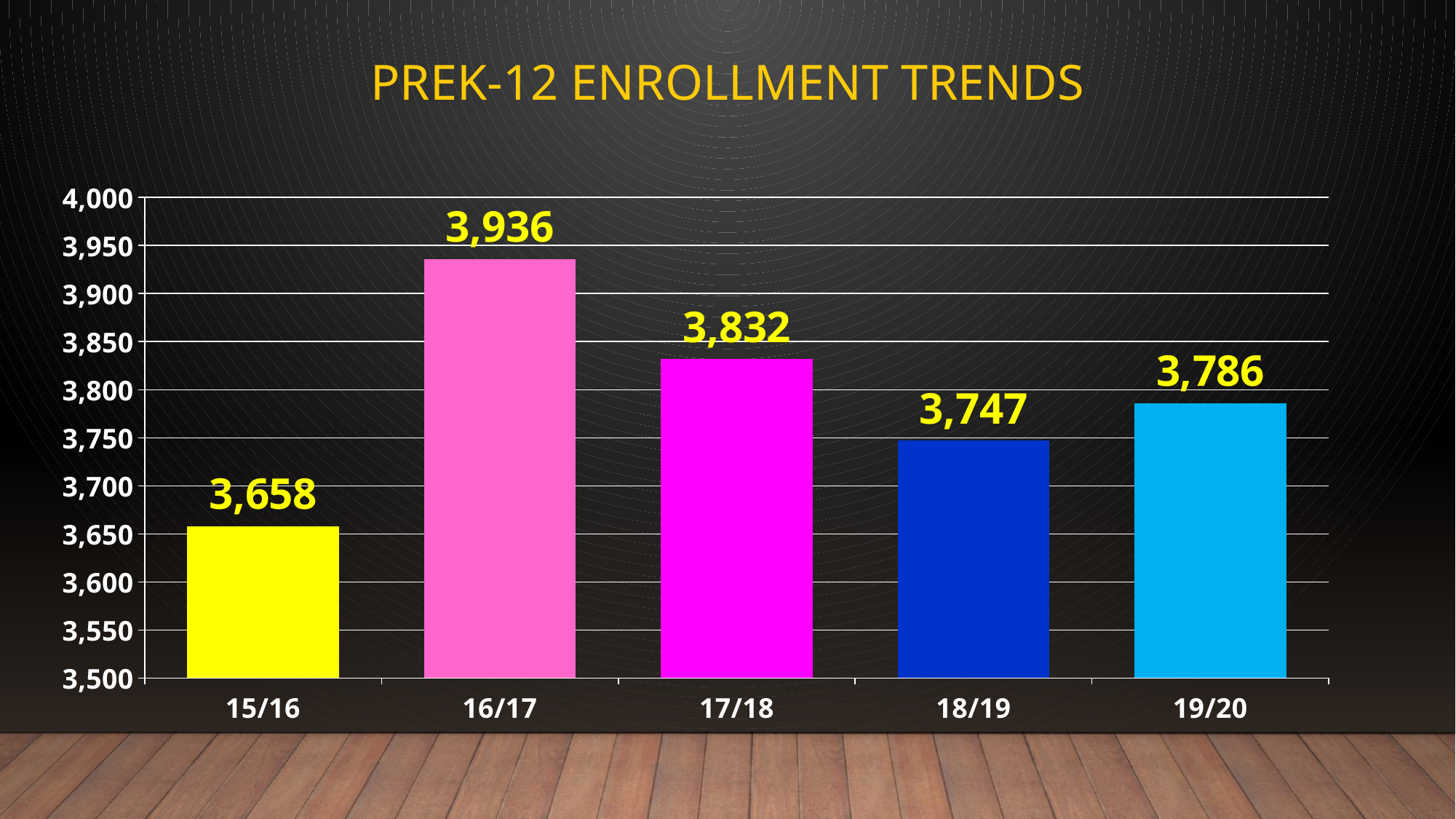
Is the value for 18/19 greater or less than 3,800? less What is the title of the chart? PREK-12 ENROLLMENT TRENDS Which has a larger enrollment, 17/18 or 19/20? 17/18 What is the enrollment value for 19/20? 3,786 What is the difference in enrollment between 16/17 and 17/18? 104 What is the enrollment value for 16/17? 3,936 Which school year has the highest enrollment? 16/17 What kind of chart is shown on the slide? bar chart How many school years are shown on the chart? 5 What is the enrollment value for 15/16? 3,658 Which school year has the lowest enrollment? 15/16 What is the difference in enrollment between 19/20 and 18/19? 39